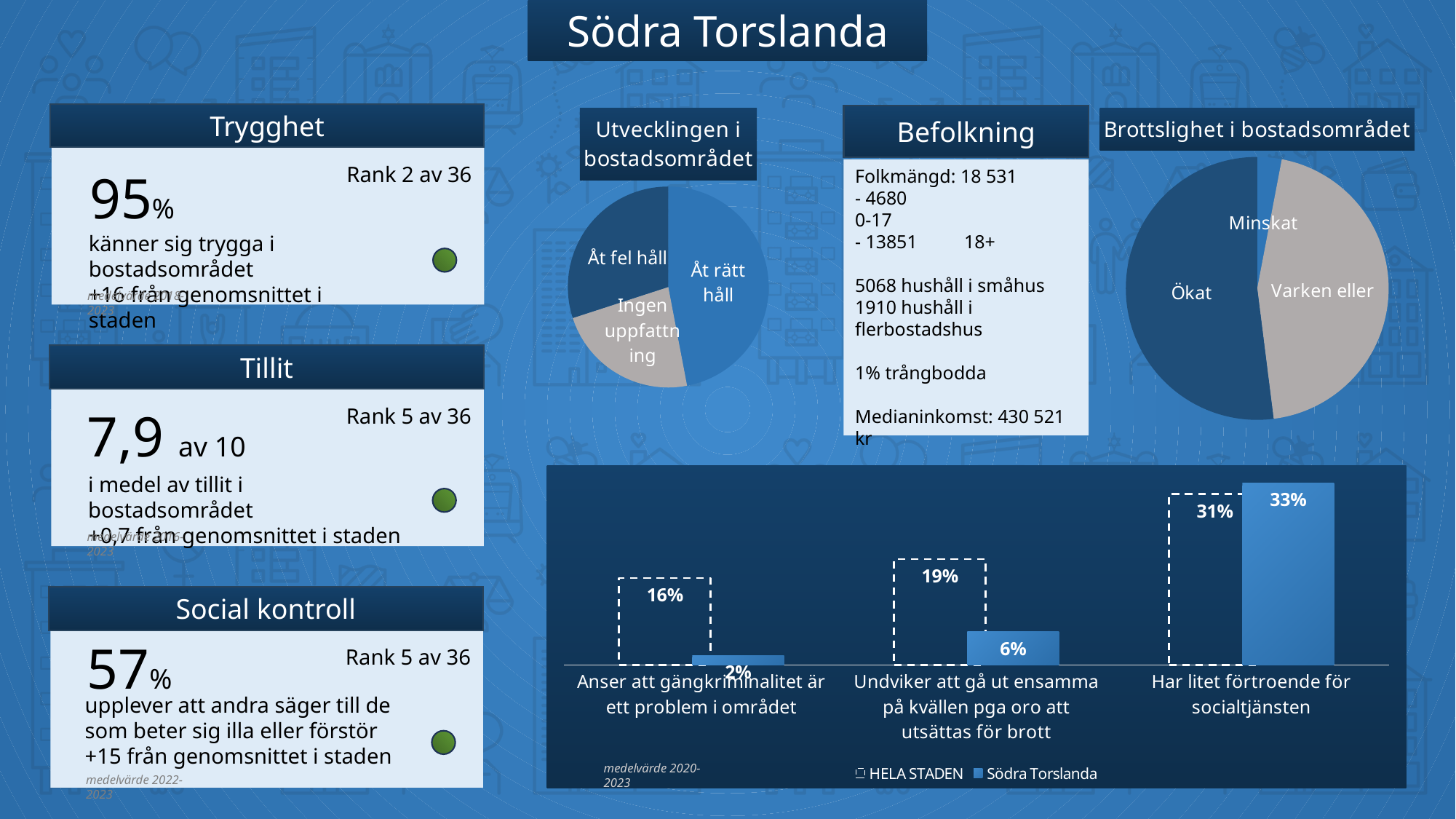
In the pie chart 'Brottslighet i bostadsområdet', which slice is the smallest? Minskat In the bottom bar chart, what is the value for HELA STADEN for 'Undviker att gå ut ensamma på kvällen pga oro att utsättas för brott'? 19% In the bottom bar chart, what is the value for Södra Torslanda for 'Undviker att gå ut ensamma på kvällen pga oro att utsättas för brott'? 6% In the pie chart 'Utvecklingen i bostadsområdet', which slice is the largest? Åt rätt håll In the bottom bar chart, which category has the highest value for Södra Torslanda? Har litet förtroende för socialtjänsten In the bottom bar chart, which category has the lowest value for Södra Torslanda? Anser att gängkriminalitet är ett problem i området In the bottom bar chart, for 'Har litet förtroende för socialtjänsten', which is larger: HELA STADEN or Södra Torslanda? Södra Torslanda In the bottom bar chart, what is the value for Södra Torslanda for 'Har litet förtroende för socialtjänsten'? 33% In the bottom bar chart, what is the value for HELA STADEN for 'Anser att gängkriminalitet är ett problem i området'? 16% How many categories are shown in the bottom bar chart? 3 In the bottom bar chart, what is the difference between HELA STADEN and Södra Torslanda for 'Anser att gängkriminalitet är ett problem i området'? 14% How many series does the legend of the bottom bar chart list? 2